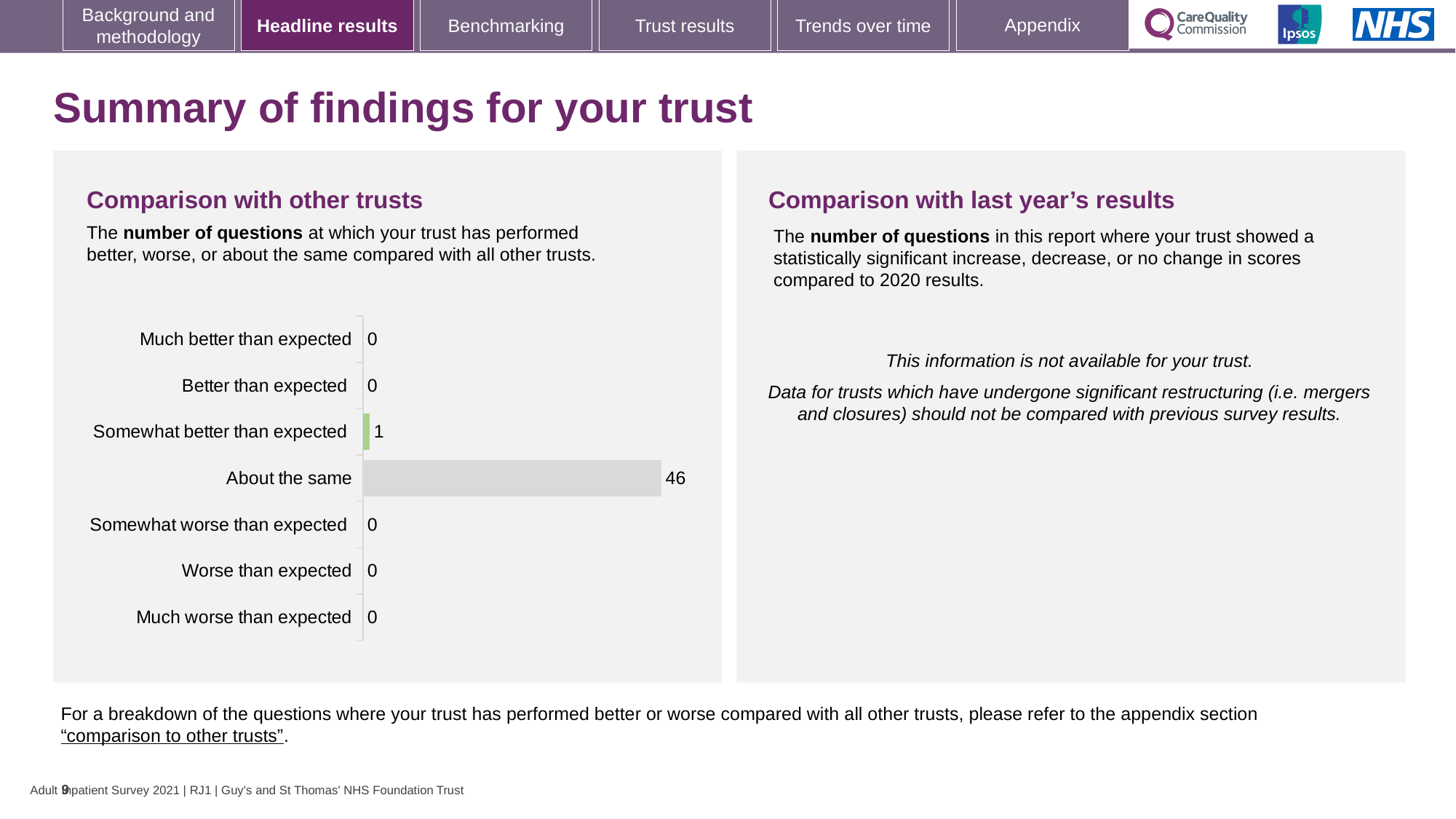
How many categories are shown in the 'Comparison with other trusts' chart? 7 In the 'Comparison with other trusts' chart, how many categories have a value of 0? 5 In the 'Comparison with other trusts' chart, what is the value for 'Somewhat better than expected'? 1 In the 'Comparison with other trusts' chart, which category has the highest value? About the same What type of chart is used in the 'Comparison with other trusts' section? Bar chart In the 'Comparison with other trusts' chart, how many questions are in the 'About the same' category? 46 What colour is the bar for 'Somewhat better than expected' in the 'Comparison with other trusts' chart? Green In the 'Comparison with other trusts' chart, what is the difference between 'About the same' and 'Somewhat better than expected'? 45 In the 'Comparison with other trusts' chart, what is the value for 'Much better than expected'? 0 In the 'Comparison with other trusts' chart, what is the total number of questions across all categories? 47 In the 'Comparison with other trusts' chart, what is the value for 'Worse than expected'? 0 In the 'Comparison with other trusts' chart, which is larger: 'Somewhat better than expected' or 'Somewhat worse than expected'? Somewhat better than expected